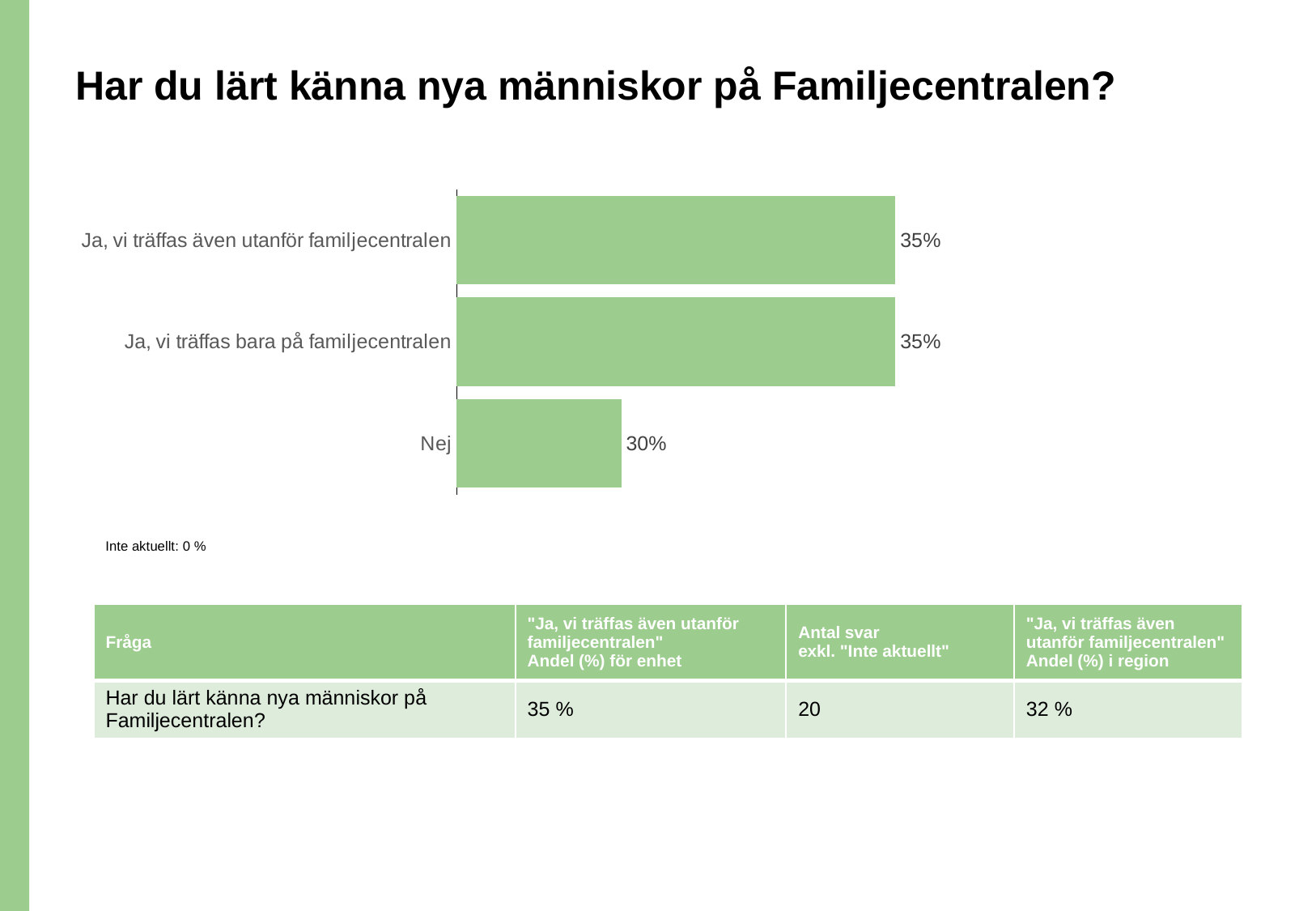
What is the total of the three values shown in the chart? 100% What is the value for "Nej"? 30% Which is larger, the value for "Ja, vi träffas även utanför familjecentralen" or the value for "Nej"? Ja, vi träffas även utanför familjecentralen What is the title of the slide? Har du lärt känna nya människor på Familjecentralen? Do the values for "Ja, vi träffas även utanför familjecentralen" and "Ja, vi träffas bara på familjecentralen" have the same value? Yes What is the value for "Ja, vi träffas bara på familjecentralen"? 35% What colour are the bars in the chart? Green What is the value for "Ja, vi träffas även utanför familjecentralen"? 35% What kind of chart is shown on the slide? Bar chart How many categories are shown in the chart? 3 What is the difference between the value for "Ja, vi träffas bara på familjecentralen" and the value for "Nej"? 5% Which category has the lowest value? Nej